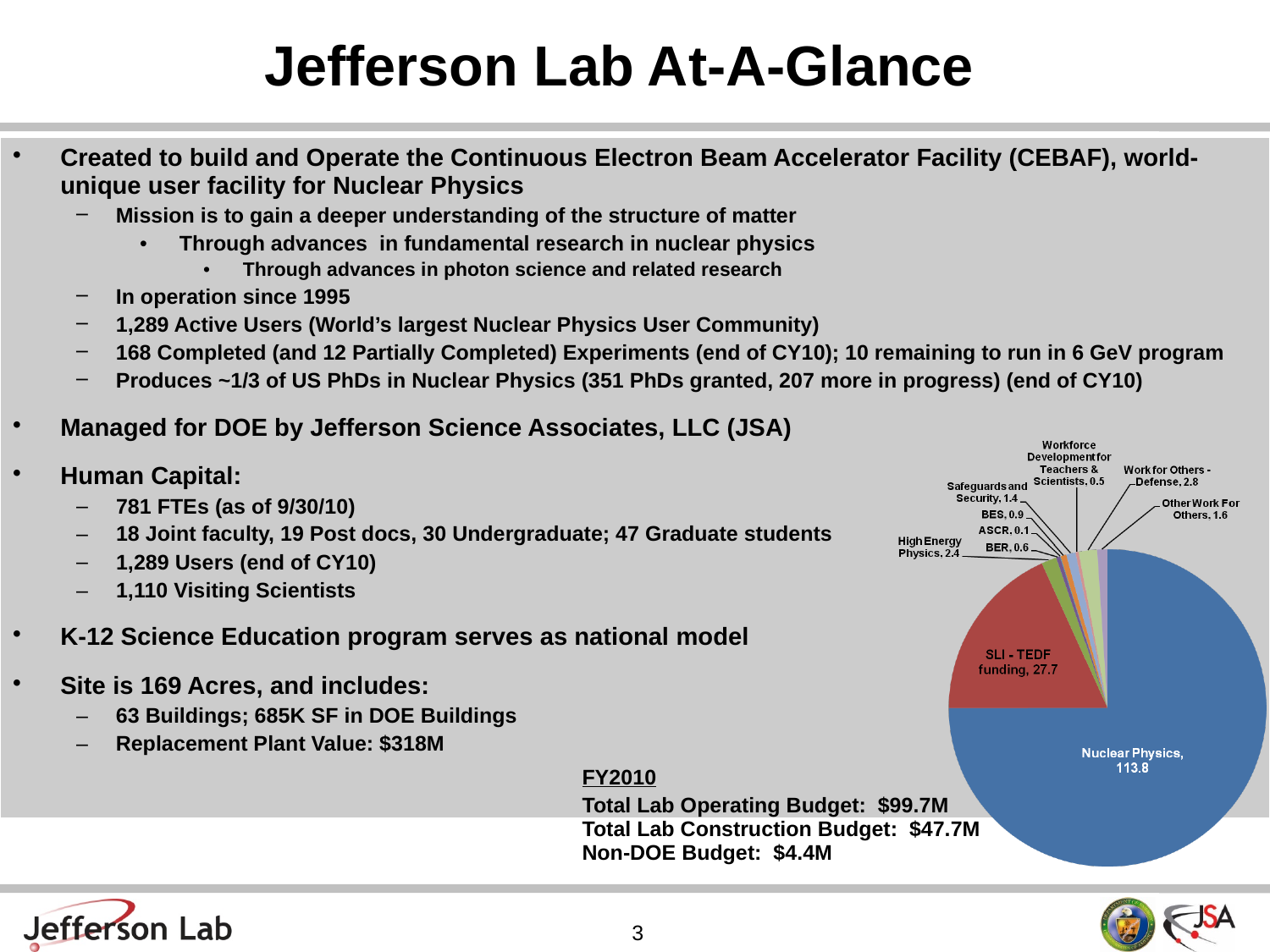
Which slice of the pie chart is the smallest? ASCR What is the value for Nuclear Physics in the pie chart? 113.8 Which slice of the pie chart is the largest? Nuclear Physics What is the value for High Energy Physics in the pie chart? 2.4 Which is larger in the pie chart, Work for Others - Defense or Other Work For Others? Work for Others - Defense What is the value for Work for Others - Defense in the pie chart? 2.8 What is the value for SLI - TEDF funding in the pie chart? 27.7 What is the difference between the Safeguards and Security value and the BES value in the pie chart? 0.5 What is the difference between the Nuclear Physics value and the SLI - TEDF funding value in the pie chart? 86.1 What kind of chart is shown on the slide? pie chart How many slices does the pie chart have? 10 What is the value for ASCR in the pie chart? 0.1